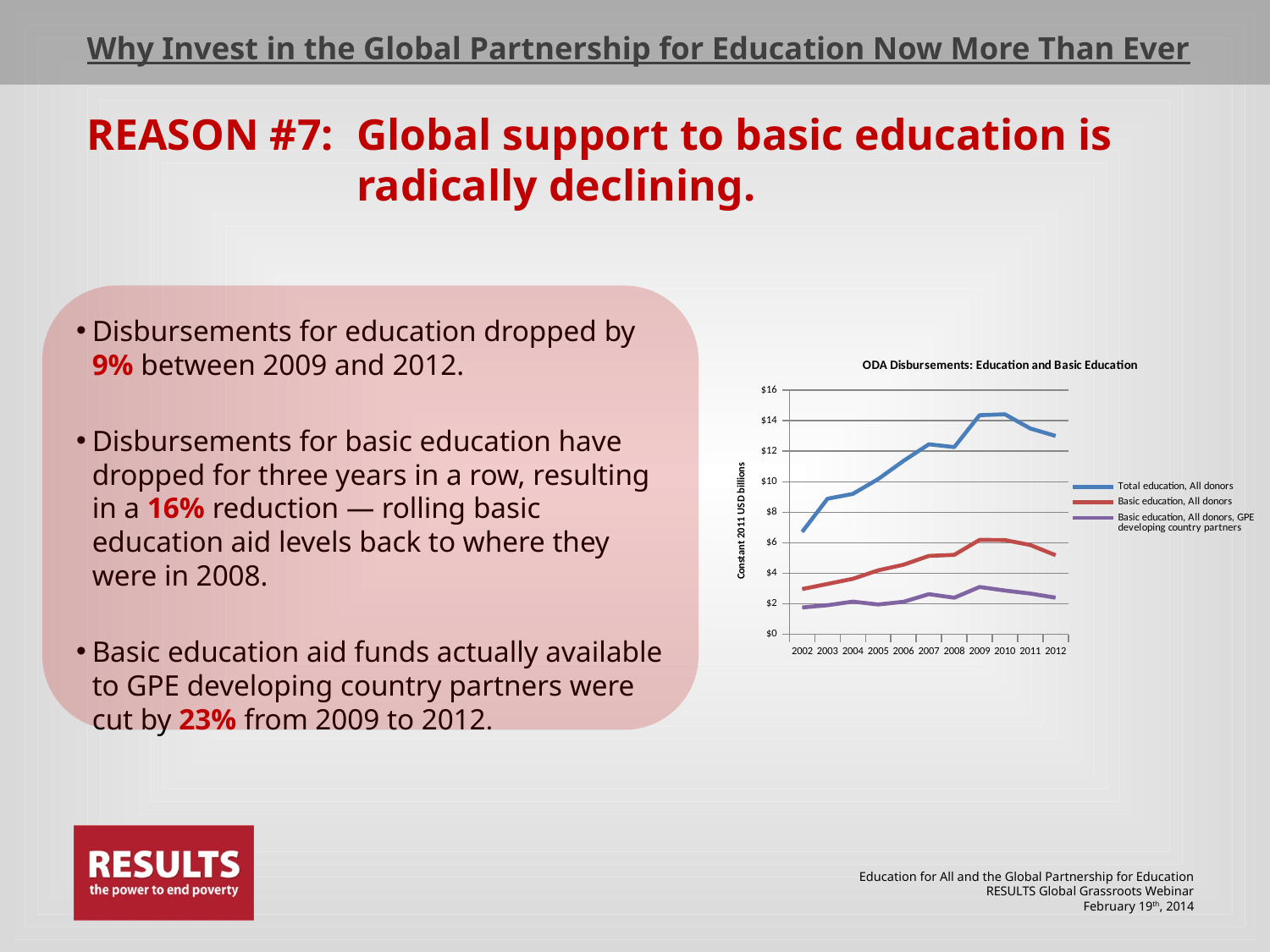
Is the value for Total education, All donors in 2012 greater or less than $12? greater Does the Total education, All donors line rise or fall between 2002 and 2009? rise In which year is the Total education, All donors series at its lowest? 2002 Is the value for Basic education, All donors in 2012 greater or less than $6? less How many series does the legend of the chart list? 3 Is the value for Basic education, All donors, GPE developing country partners in 2009 greater or less than $4? less How many years are plotted along the x axis of the chart? 11 What is the label on the y axis of the chart? Constant 2011 USD billions In 2012, which series has the larger value: Total education, All donors or Basic education, All donors? Total education, All donors Does the Basic education, All donors line rise or fall between 2010 and 2012? fall What kind of chart is shown on the slide? line chart